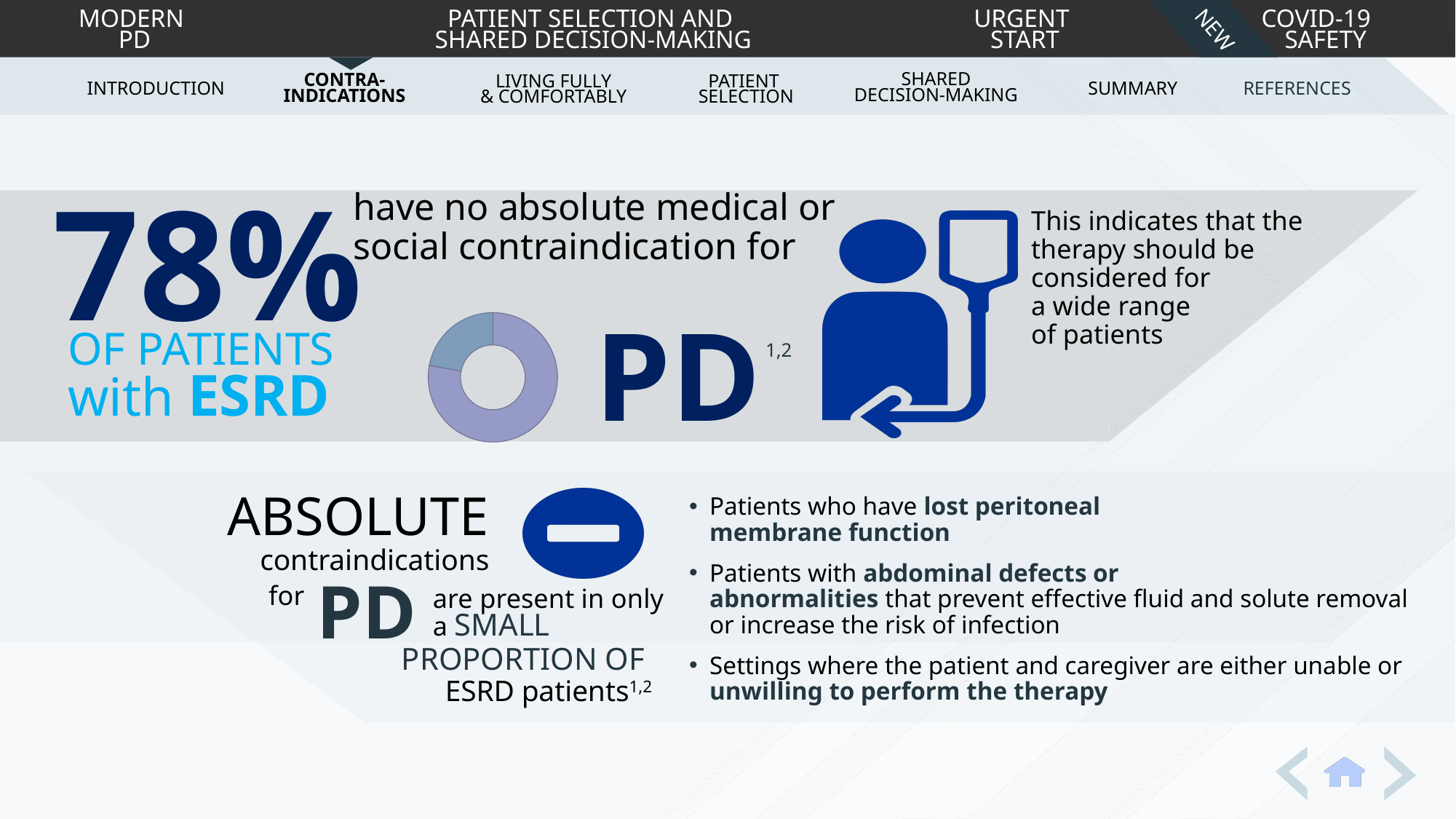
Which slice of the donut chart is larger, the purple slice or the light blue slice? The purple slice What does the 78% shown beside the donut chart refer to? Patients with ESRD who have no absolute medical or social contraindication for PD What percentage of patients with ESRD does the large slice of the donut chart represent? 78% Does the donut chart include a legend? No Is the share represented by the small light blue slice of the donut chart greater or less than 50%? less Is the share represented by the large purple slice of the donut chart greater or less than 50%? greater What kind of chart is shown next to the 78% statistic? Donut (pie) chart How many slices does the donut chart have? 2